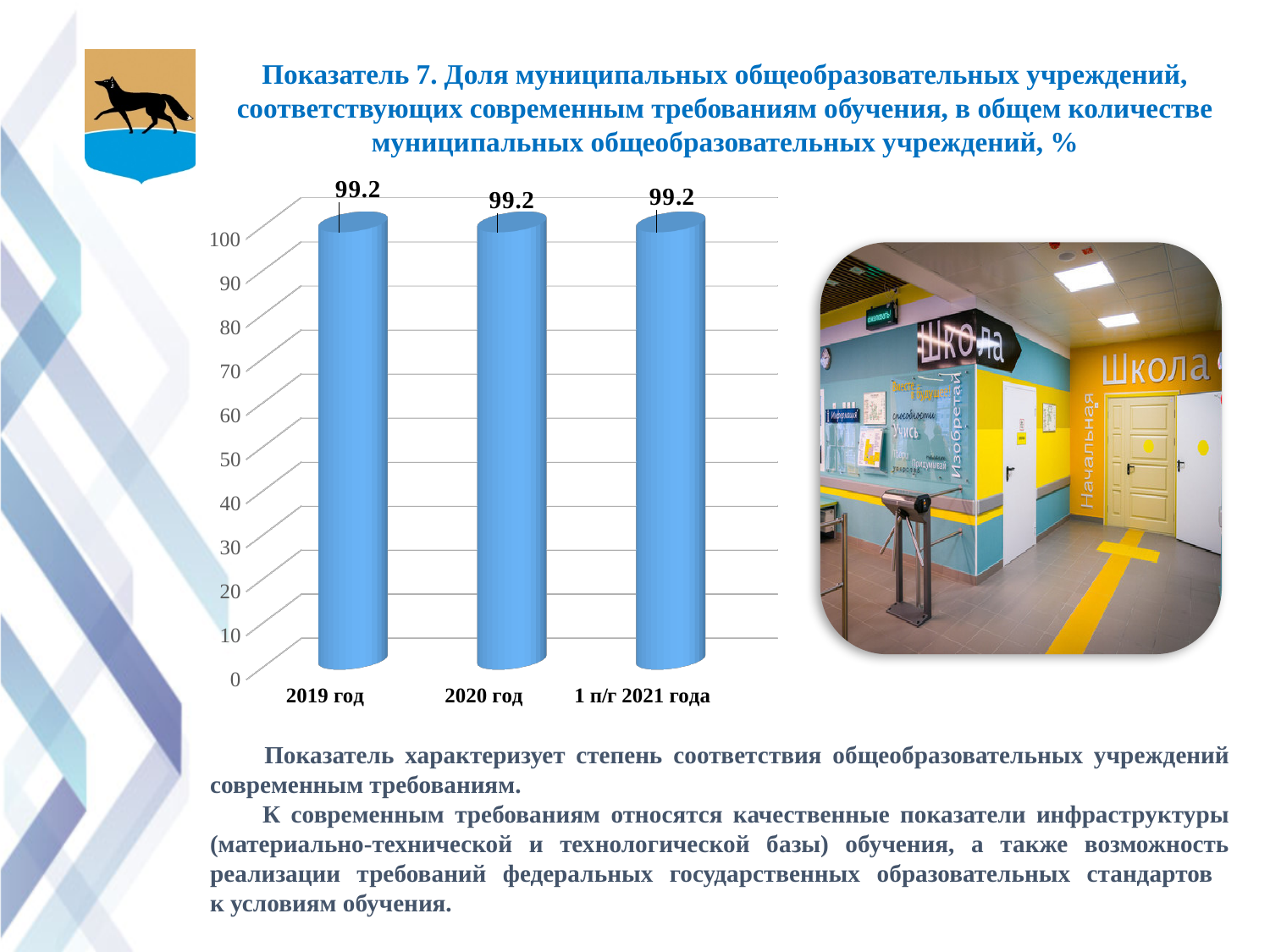
What colour are the bars on the chart? blue What is the value for 2020 год? 99.2 What is the difference between the values for 2020 год and 2019 год? 0 What is the value for 1 п/г 2021 года? 99.2 What kind of chart is shown on the slide? bar chart Is the value for 2019 год greater or less than 90? greater Is the value for 1 п/г 2021 года greater or less than 50? greater What is the highest tick value shown on the vertical axis? 100 Do the values rise, fall or stay the same from 2019 год to 1 п/г 2021 года? stay the same How many categories are plotted on the chart? 3 What is the value for 2019 год? 99.2